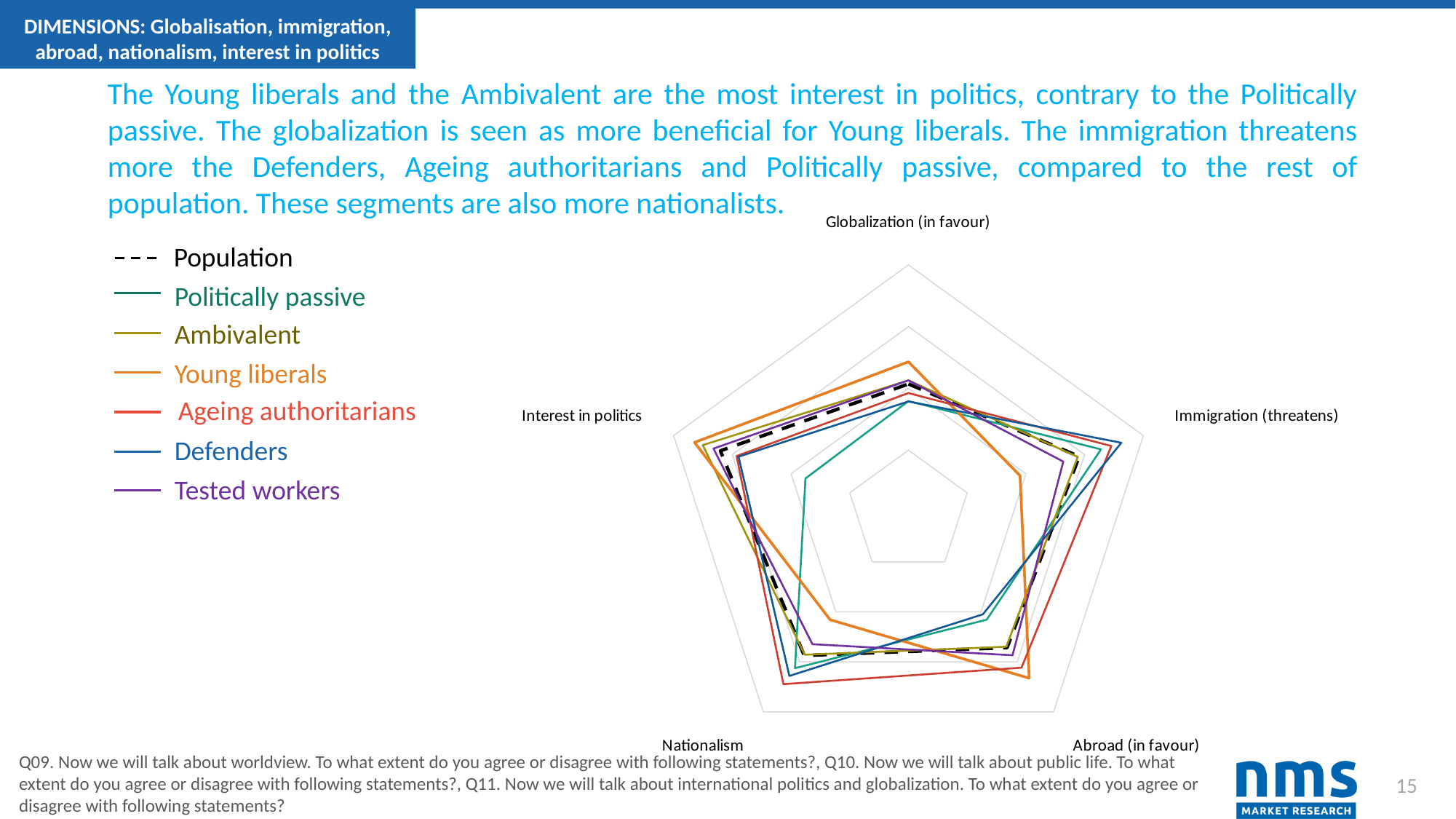
Which segment has the highest value on the Nationalism axis? Ageing authoritarians Which segment has the highest value on the Abroad (in favour) axis? Young liberals Which series is drawn with a dashed line in the legend? Population How many series does the legend list? 7 How many dimensions (axes) does the radar chart have? 5 Which segment has the lowest value on the Interest in politics axis? Politically passive On the Interest in politics axis, which is larger: Young liberals or Politically passive? Young liberals On the Immigration (threatens) axis, which is larger: Defenders or Young liberals? Defenders Which segment has the lowest value on the Immigration (threatens) axis? Young liberals What kind of chart is shown on the slide? Radar chart Which segment has the highest value on the Globalization (in favour) axis? Young liberals